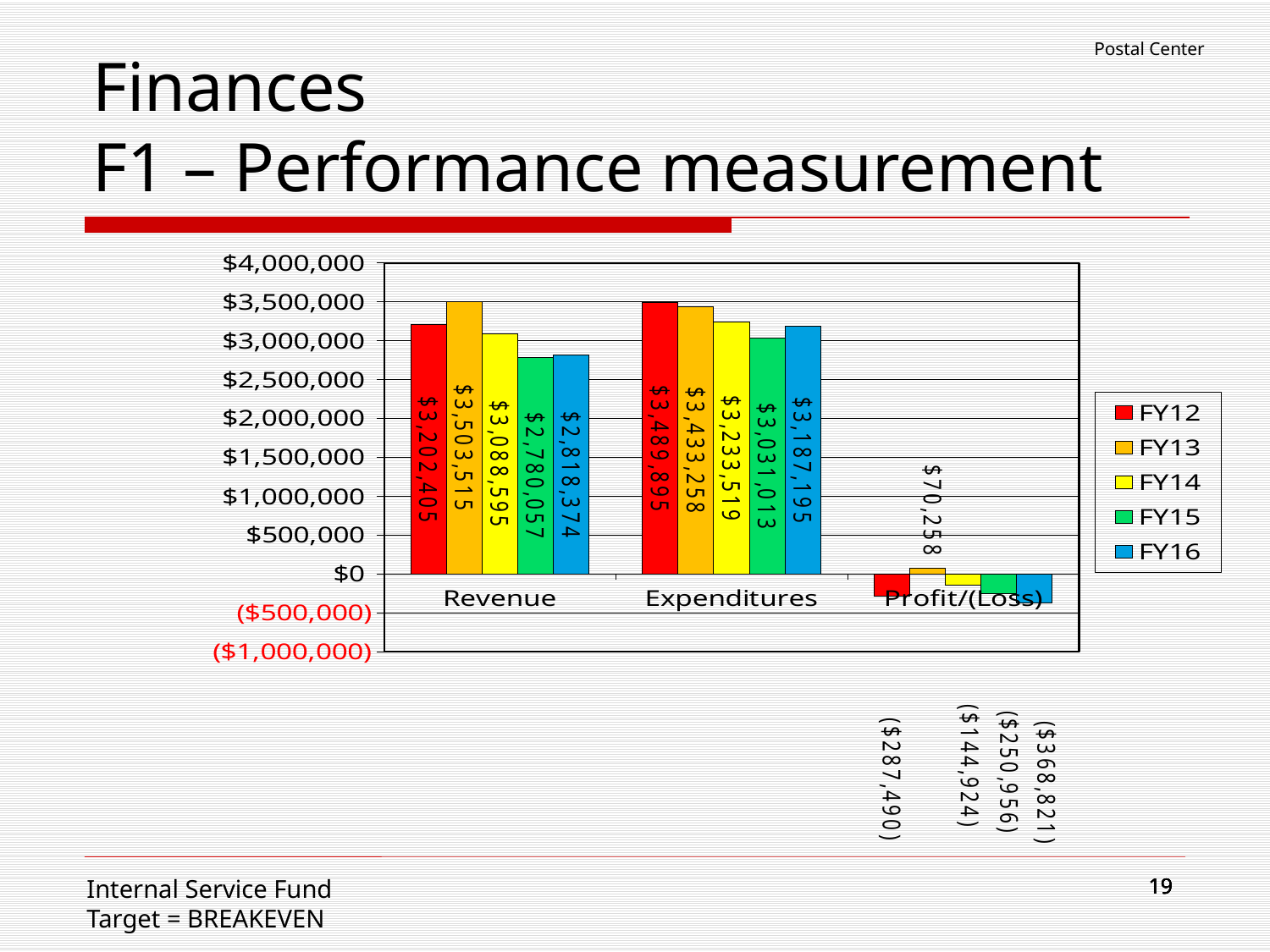
How many categories are shown on the x axis? 3 What is the Profit/(Loss) value for FY13? $70,258 What kind of chart is shown on the slide? Bar chart For FY16, which is larger: Revenue or Expenditures? Expenditures What colour represents FY12 in the legend? Red What is the Expenditures value for FY15? $3,031,013 Which fiscal year has the lowest Revenue? FY15 What is the Revenue value for FY13? $3,503,515 Which fiscal year has the highest Revenue? FY13 Which fiscal year has the highest Expenditures? FY12 How many series does the legend list? 5 What is the difference between FY13 Revenue and FY12 Revenue? $301,110